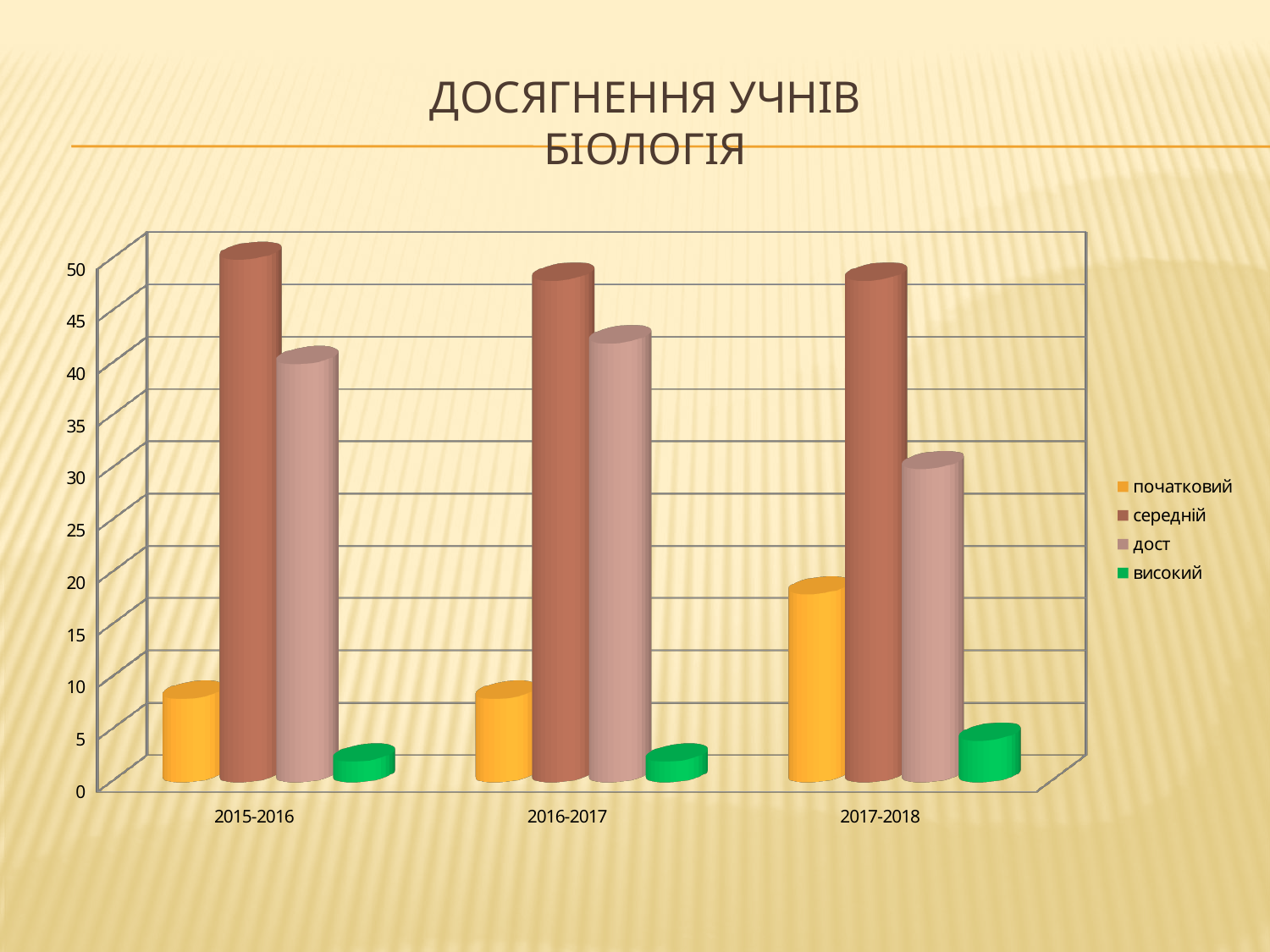
Is the value for початковий larger in 2016-2017 or in 2017-2018? 2017-2018 Which series has the lowest value for 2015-2016? високий Is the value for середній in 2015-2016 greater or less than 40? greater Is the value for дост larger in 2016-2017 or in 2017-2018? 2016-2017 Which colour represents the високий series in the legend? green How many series does the legend list? 4 Is the value for дост in 2017-2018 greater or less than 40? less What kind of chart is shown on the slide? bar chart Which series has the lowest value for 2017-2018? високий Which series has the highest value for 2015-2016? середній Which series has the highest value for 2017-2018? середній How many school-year categories are shown on the x axis? 3